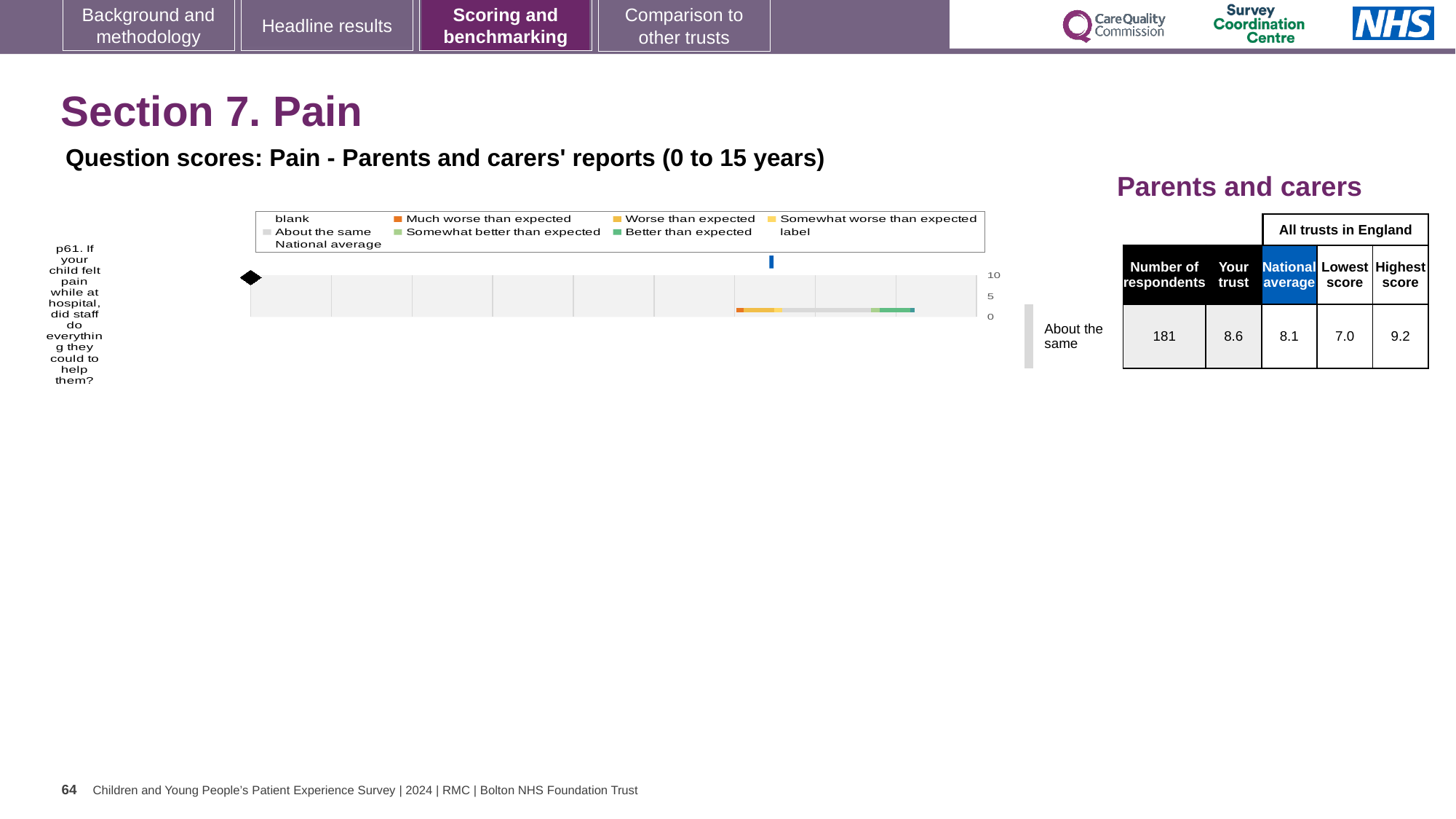
For question p61, how much higher is the 'Your trust' score than the national average? 0.5 For question p61, what is the difference between the highest score and the lowest score among all trusts in England? 2.2 What is the highest score among all trusts in England for question p61? 9.2 How many respondents answered question p61 according to the Parents and carers table? 181 How many survey questions are plotted in the Pain question scores chart? 1 What is the lowest score among all trusts in England for question p61? 7.0 What is the national average score for question p61 in the Parents and carers table? 8.1 Which benchmarking category is assigned to question p61 on the slide? About the same What kind of chart is shown on the slide for the Pain question scores? bar chart What is the 'Your trust' score for question p61 in the Parents and carers table? 8.6 For question p61, which is larger: the 'Your trust' score or the national average? Your trust Which survey question is plotted in the Pain question scores chart? p61. If your child felt pain while at hospital, did staff do everything they could to help them?